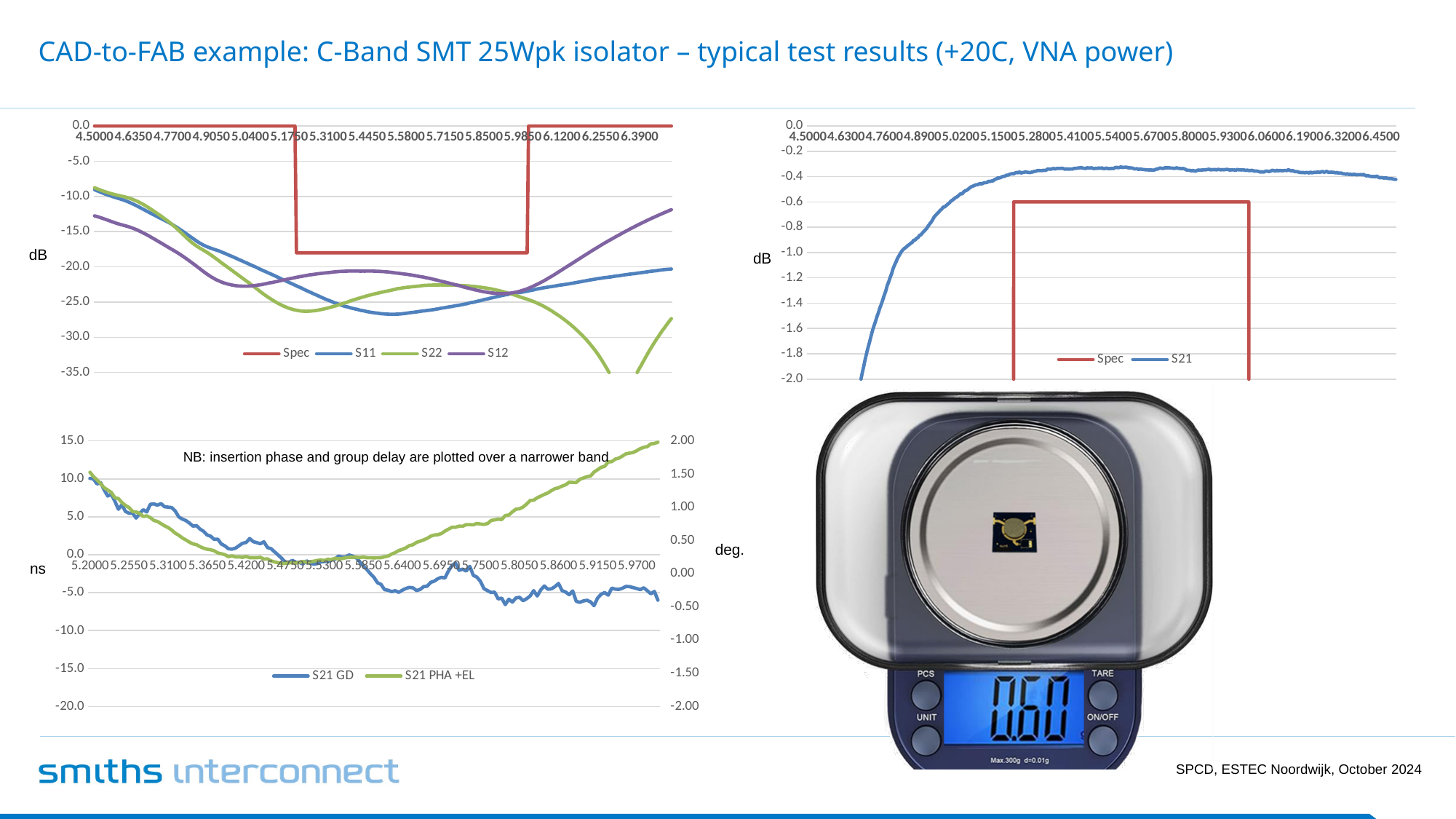
In the top-right chart, is the S21 value at 4.6300 greater or less than -1.0 dB? less In the top-right chart, is the S21 value at 5.5400 greater or less than -0.6 dB? greater In the top-left chart, how many series does the legend list? 4 In the top-right chart, how many series does the legend list? 2 What kind of chart is the top-right chart? Line chart What unit is shown on the right axis of the bottom-left chart? deg. In the bottom-left chart, does the S21 PHA +EL line rise or fall between 5.6400 and 5.9700? rise What unit is shown on the left axis of the bottom-left chart? ns In the bottom-left chart, does the S21 GD line rise or fall overall from 5.2000 to 5.9700? fall In the bottom-left chart, how many series does the legend list? 2 In the top-left chart, is the Spec value inside the band (between about 5.1750 and 5.9850) greater or less than -15.0 dB? less